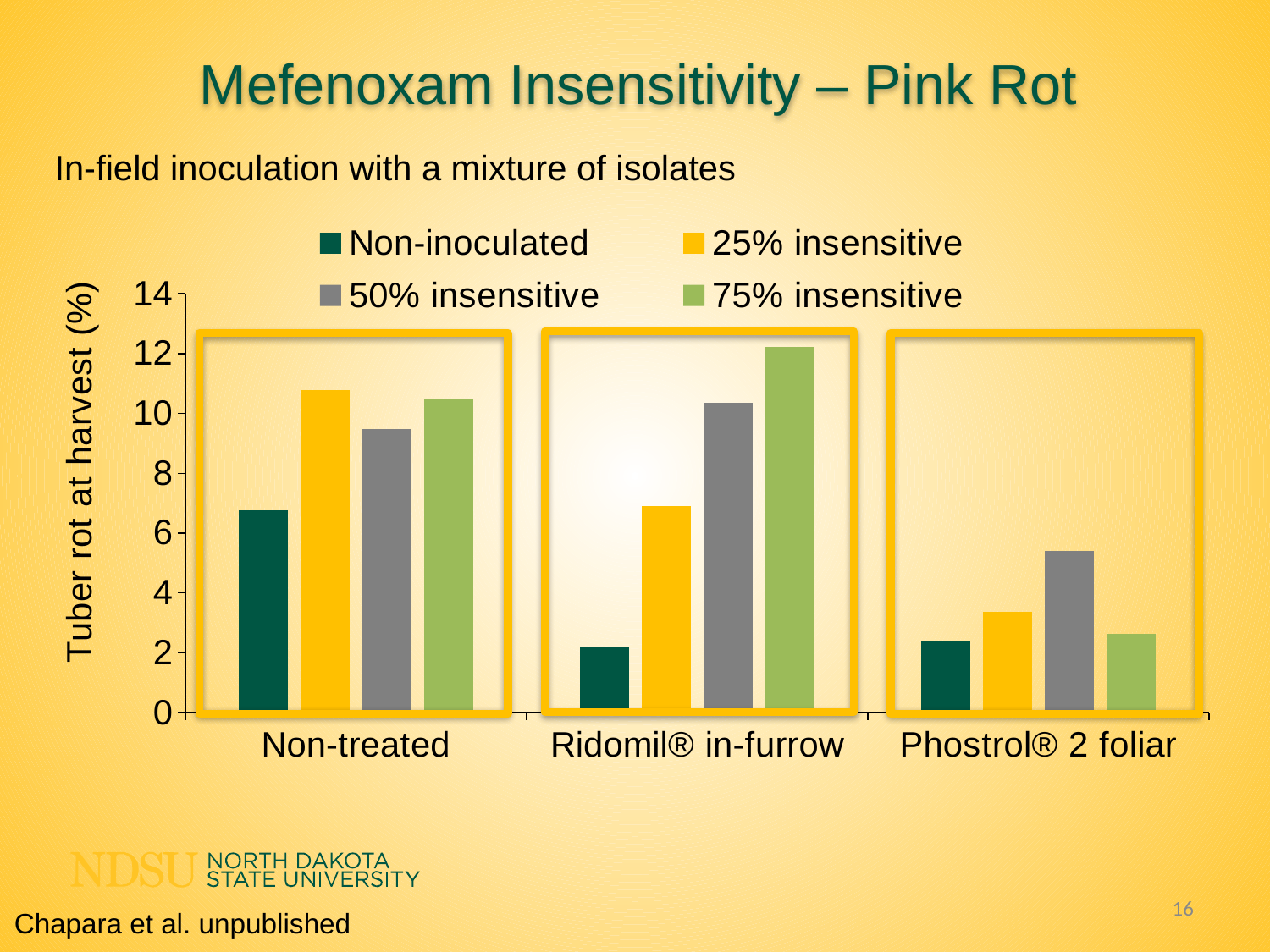
How many treatment categories are shown on the x axis? 3 Is the value for Non-inoculated under Non-treated greater or less than 8? less What is the label of the y axis? Tuber rot at harvest (%) Is the value for 25% insensitive under Ridomil® in-furrow greater or less than 8? less Within the Phostrol® 2 foliar group, which series has the highest tuber rot? 50% insensitive How many series does the legend list? 4 Is the value for 75% insensitive under Ridomil® in-furrow greater or less than 10? greater For the Non-inoculated series, which is larger: Non-treated or Ridomil® in-furrow? Non-treated Which bar is the highest in the whole chart? 75% insensitive under Ridomil® in-furrow What kind of chart is shown on the slide? Bar chart Under Non-treated, which is larger: 25% insensitive or 50% insensitive? 25% insensitive Within the Ridomil® in-furrow group, which series has the lowest tuber rot? Non-inoculated